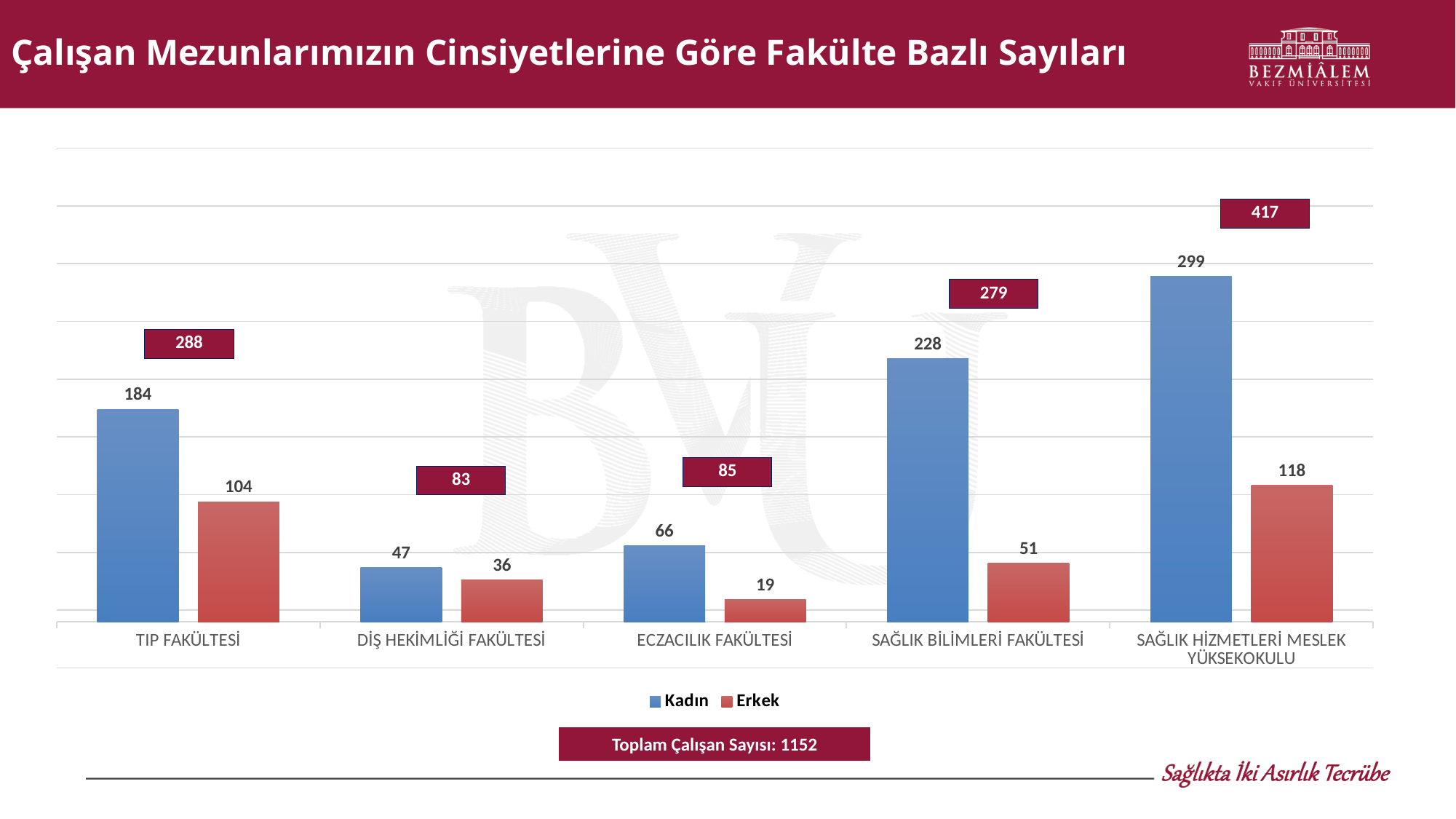
What is the combined total of Kadın and Erkek for SAĞLIK HİZMETLERİ MESLEK YÜKSEKOKULU, as labelled on the slide? 417 How many categories are shown on the x axis? 5 What kind of chart is shown on the slide? Bar chart What is the Kadın value for TIP FAKÜLTESİ? 184 Which category has the lowest Erkek value? ECZACILIK FAKÜLTESİ Which is larger: the Kadın value for DİŞ HEKİMLİĞİ FAKÜLTESİ or the Kadın value for ECZACILIK FAKÜLTESİ? ECZACILIK FAKÜLTESİ What is the Erkek value for ECZACILIK FAKÜLTESİ? 19 What is the difference between the Kadın and Erkek values for TIP FAKÜLTESİ? 80 What is the Erkek value for SAĞLIK BİLİMLERİ FAKÜLTESİ? 51 How many series does the legend list? 2 What total number of employees (Toplam Çalışan Sayısı) is stated below the chart? 1152 Which category has the highest Kadın value? SAĞLIK HİZMETLERİ MESLEK YÜKSEKOKULU